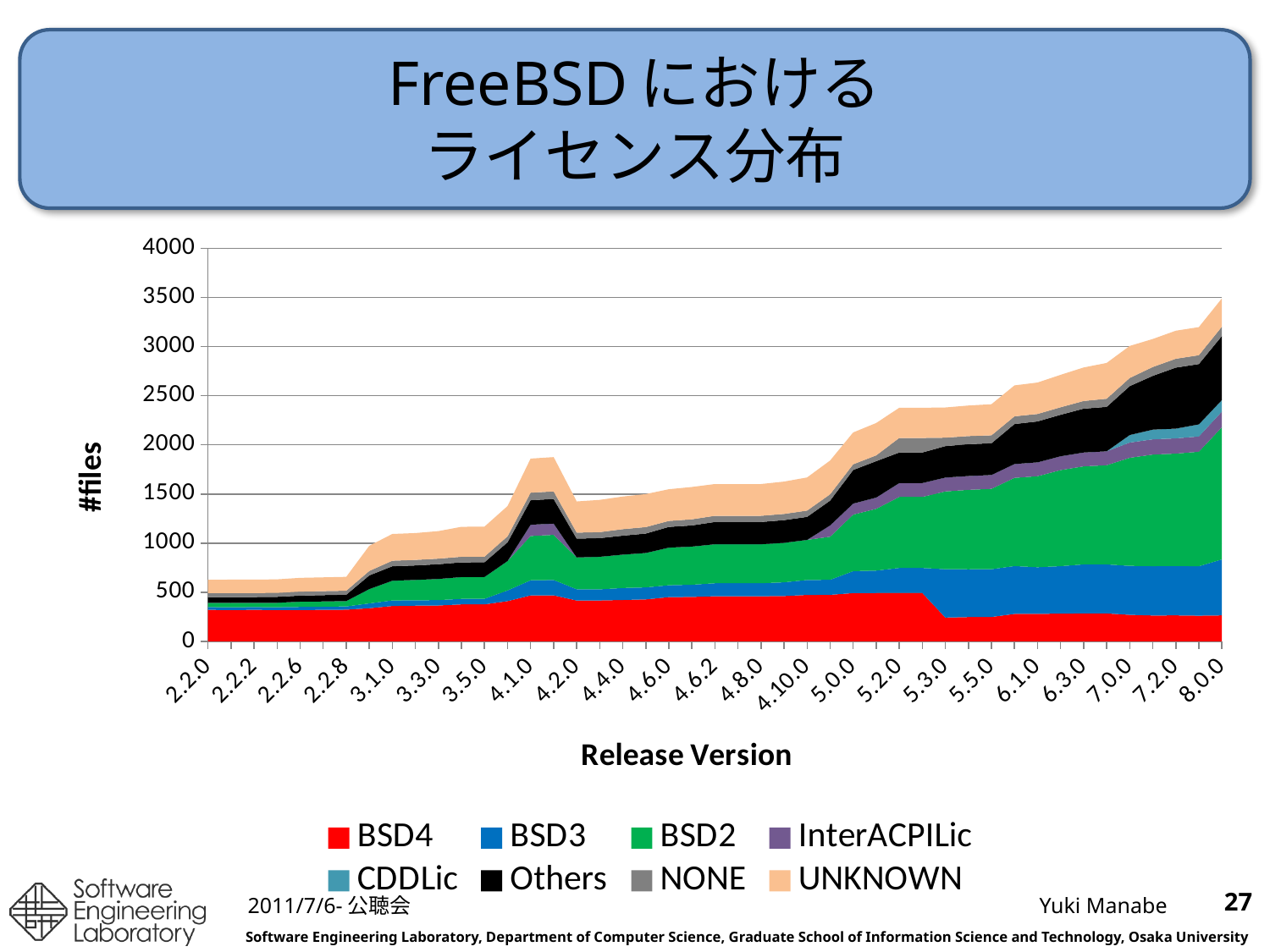
Is the total number of files at release 8.0.0 greater or less than 3000? greater Is the total number of files at release 4.1.0 greater or less than 1500? greater Is the number of BSD4 files at release 8.0.0 greater or less than 500? less What kind of chart is shown on the slide? stacked area chart Which release version has the highest total number of files? 8.0.0 How many release versions are labelled on the x axis? 23 Does the total number of files generally rise or fall from release 2.2.0 to release 8.0.0? rise What is the label of the y axis? #files How many series does the legend list? 8 Which release has a larger total number of files, 2.2.0 or 8.0.0? 8.0.0